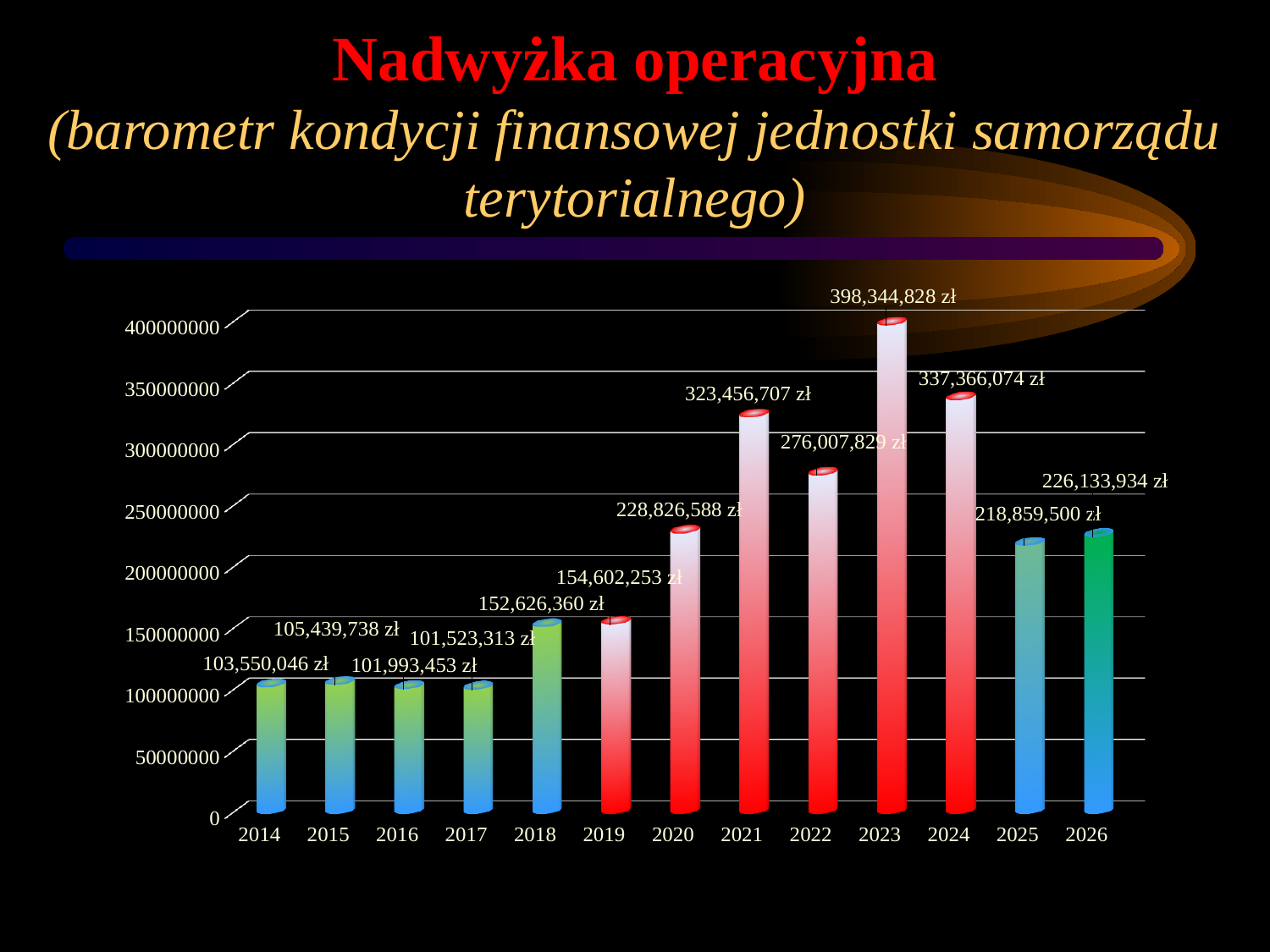
What is the value for 2023? 398,344,828 zł What is the value for 2020? 228,826,588 zł What kind of chart is shown on the slide? bar chart How many years are shown on the x axis? 13 Which year has the highest value? 2023 Which is larger, the value for 2021 or the value for 2022? 2021 What is the value for 2025? 218,859,500 zł Is the value for 2021 greater or less than 300000000? greater What is the difference between the values for 2023 and 2024? 60,978,754 zł What is the difference between the values for 2026 and 2025? 7,274,434 zł What is the value for 2014? 103,550,046 zł Which year has the lowest value? 2017